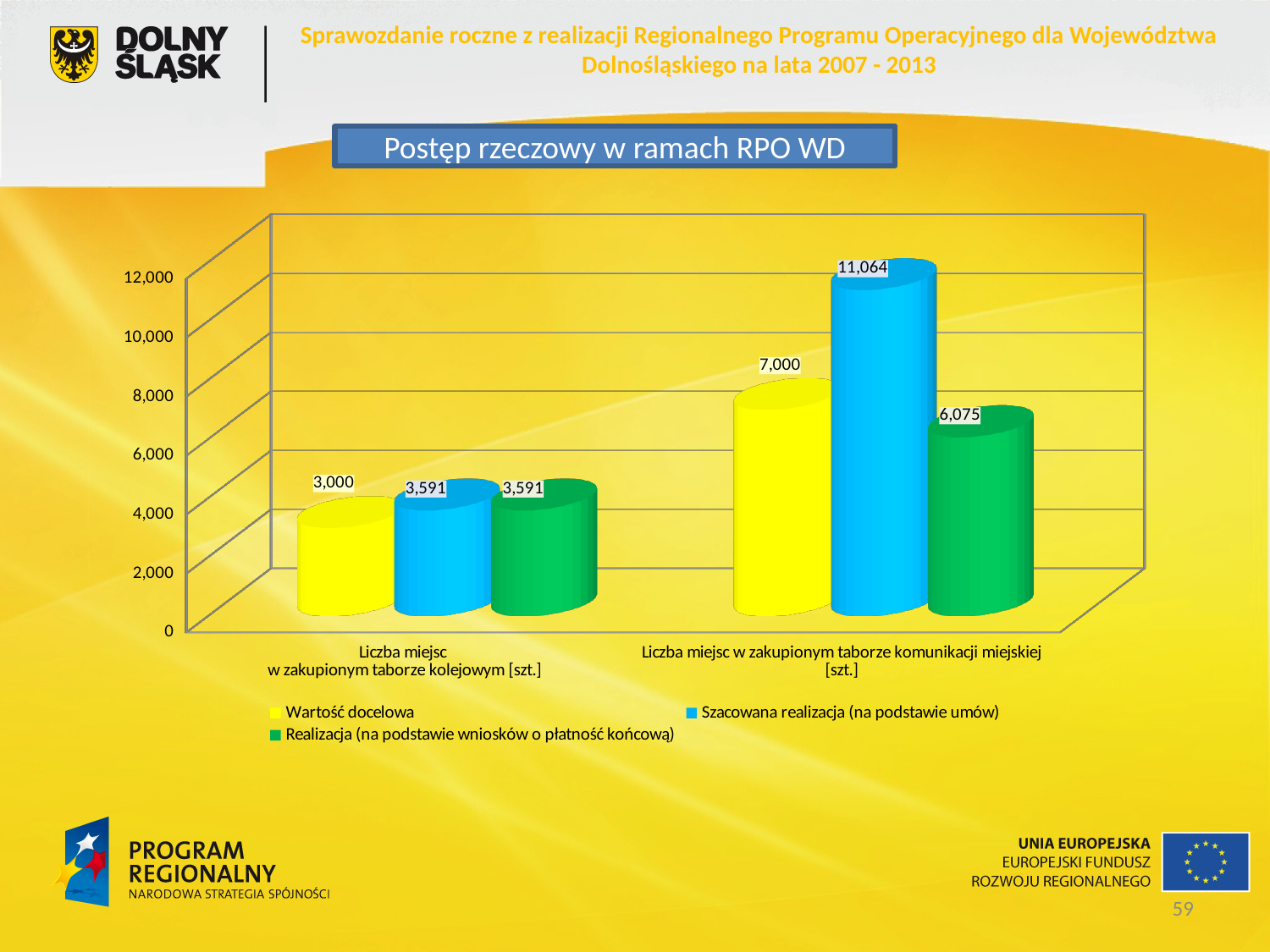
What kind of chart is shown on the slide? Bar chart What is the 'Wartość docelowa' value for 'Liczba miejsc w zakupionym taborze komunikacji miejskiej [szt.]'? 7,000 How many series does the legend list? 3 How many categories are shown on the x axis? 2 What is the 'Szacowana realizacja (na podstawie umów)' value for 'Liczba miejsc w zakupionym taborze komunikacji miejskiej [szt.]'? 11,064 Which is larger: 'Wartość docelowa' or 'Realizacja (na podstawie wniosków o płatność końcową)' for 'Liczba miejsc w zakupionym taborze komunikacji miejskiej [szt.]'? Wartość docelowa What is the 'Wartość docelowa' value for 'Liczba miejsc w zakupionym taborze kolejowym [szt.]'? 3,000 Which series has the highest value for 'Liczba miejsc w zakupionym taborze komunikacji miejskiej [szt.]'? Szacowana realizacja (na podstawie umów) What is the difference between 'Szacowana realizacja (na podstawie umów)' and 'Wartość docelowa' for 'Liczba miejsc w zakupionym taborze kolejowym [szt.]'? 591 Which series has the lowest value for 'Liczba miejsc w zakupionym taborze kolejowym [szt.]'? Wartość docelowa What is the difference between 'Szacowana realizacja (na podstawie umów)' and 'Wartość docelowa' for 'Liczba miejsc w zakupionym taborze komunikacji miejskiej [szt.]'? 4,064 What is the 'Realizacja (na podstawie wniosków o płatność końcową)' value for 'Liczba miejsc w zakupionym taborze komunikacji miejskiej [szt.]'? 6,075